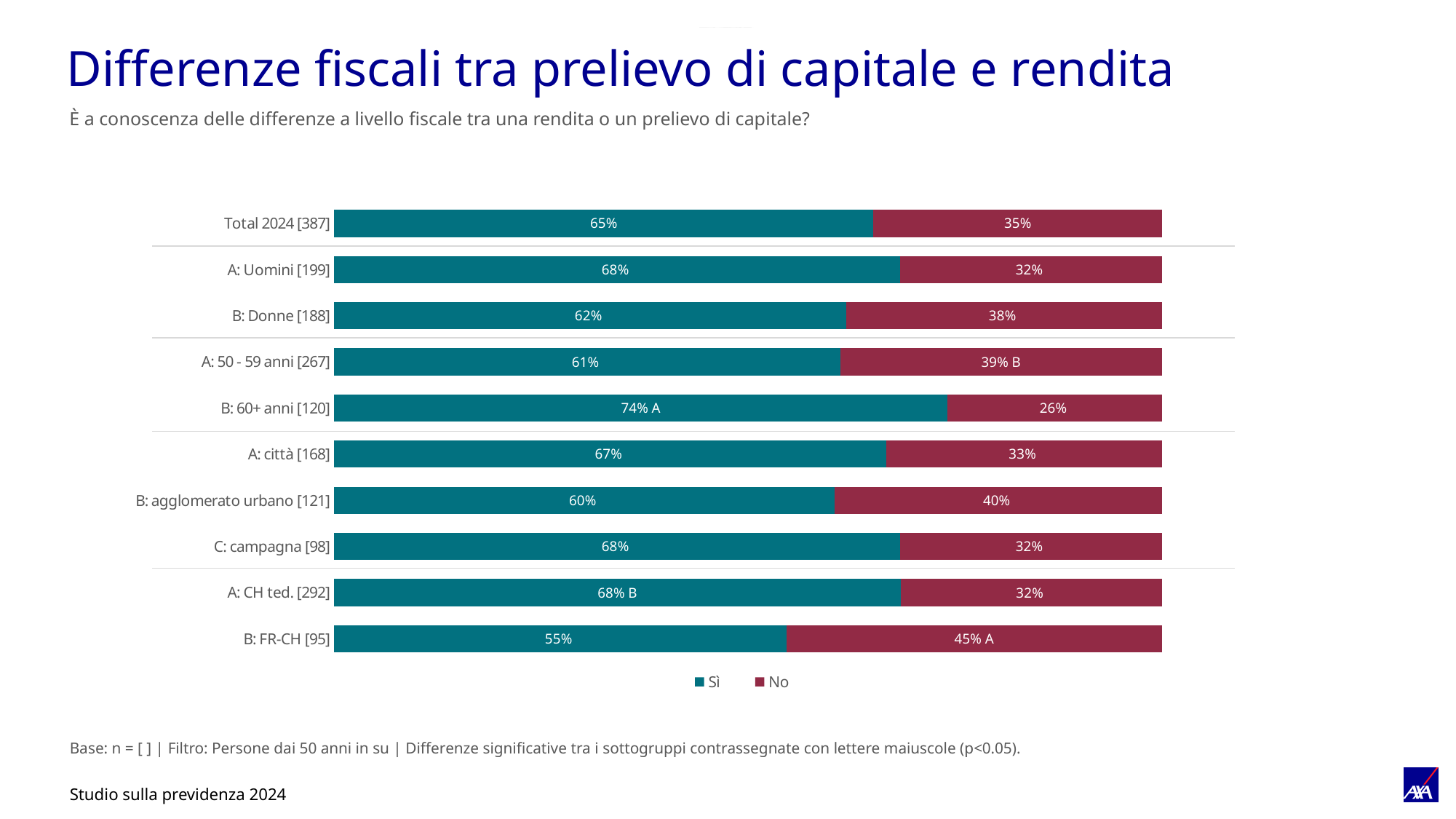
How many series does the legend list? 2 Which category has the lowest 'Sì' value? B: FR-CH [95] Which category has the highest 'Sì' value? B: 60+ anni [120] How many categories are shown in the chart? 10 What is the 'No' value for B: Donne [188]? 38% What is the 'Sì' value for Total 2024 [387]? 65% What is the 'No' value for B: FR-CH [95]? 45% What is the total of the stacked bar for A: CH ted. [292]? 100% What is the 'Sì' value for B: 60+ anni [120]? 74% What kind of chart is shown on the slide? Stacked bar chart Which has a larger 'No' value, A: città [168] or B: agglomerato urbano [121]? B: agglomerato urbano [121] What is the difference between the 'Sì' values for A: Uomini [199] and B: Donne [188]? 6%